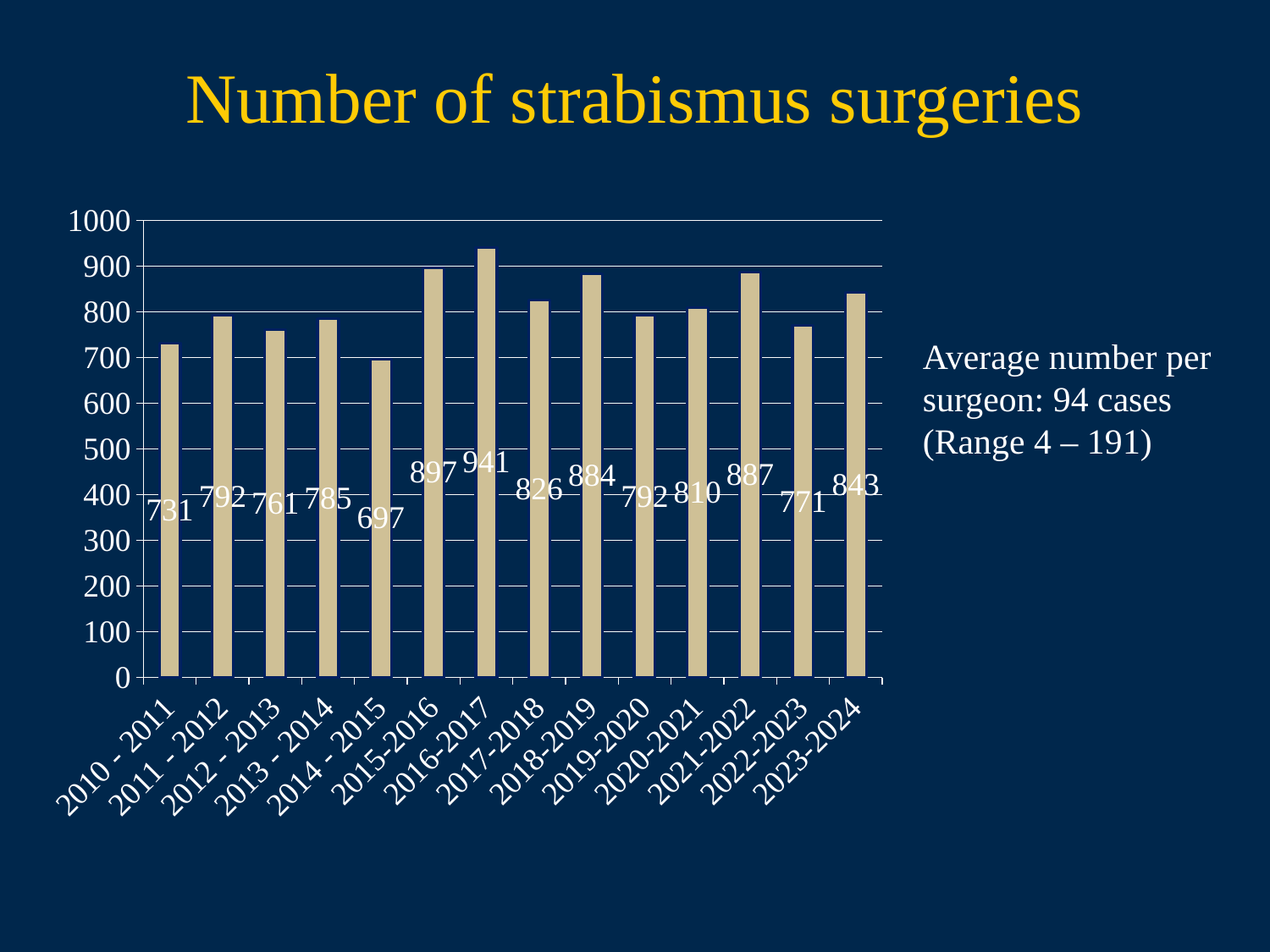
What is the number of strabismus surgeries for 2016-2017? 941 What is the number of strabismus surgeries for 2023-2024? 843 Which year has the lowest number of strabismus surgeries? 2014-2015 What is the number of strabismus surgeries for 2014-2015? 697 What is the title of the chart? Number of strabismus surgeries Which year had more strabismus surgeries, 2015-2016 or 2021-2022? 2015-2016 What kind of chart is shown on the slide? Bar chart What is the difference between the number of surgeries in 2023-2024 and 2022-2023? 72 Which year has the highest number of strabismus surgeries? 2016-2017 Is the number of surgeries for 2017-2018 greater or less than 800? greater How many years (categories) are shown on the chart? 14 What is the difference between the number of surgeries in 2016-2017 and 2014-2015? 244